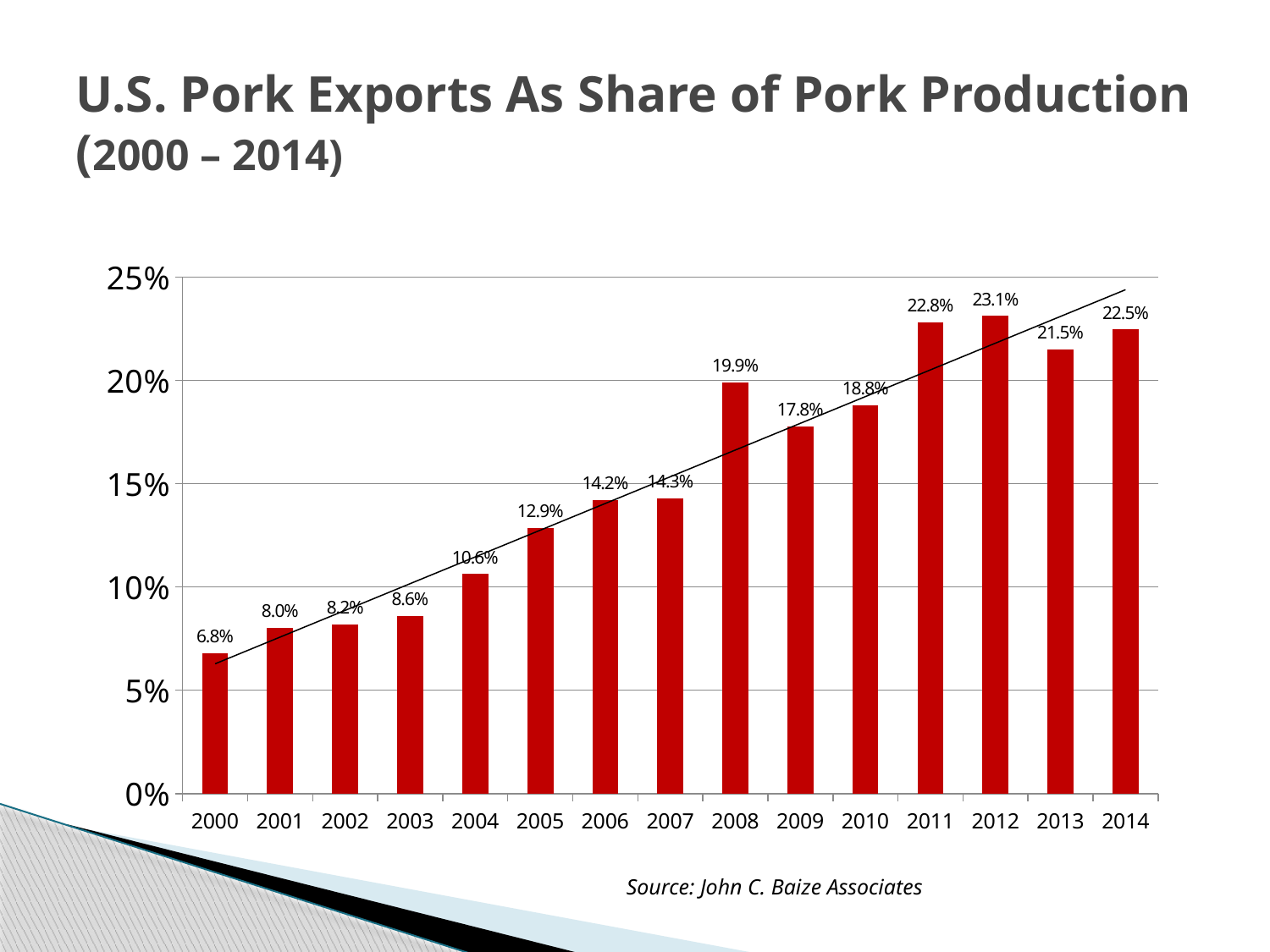
What value is shown for 2000? 6.8% What is the overall trend of the export share from 2000 to 2014? rising Which year has the highest export share? 2012 What is the difference between the 2014 value and the 2000 value? 15.7% How many years are shown on the x axis? 15 What kind of chart is this? bar chart What was the U.S. pork export share of pork production in 2008? 19.9% Is the value for 2010 greater or less than 20%? less Which is larger, the value for 2011 or the value for 2014? 2011 What is the difference between the 2008 and 2009 values? 2.1% Which year has the lowest export share? 2000 What was the export share in 2013? 21.5%